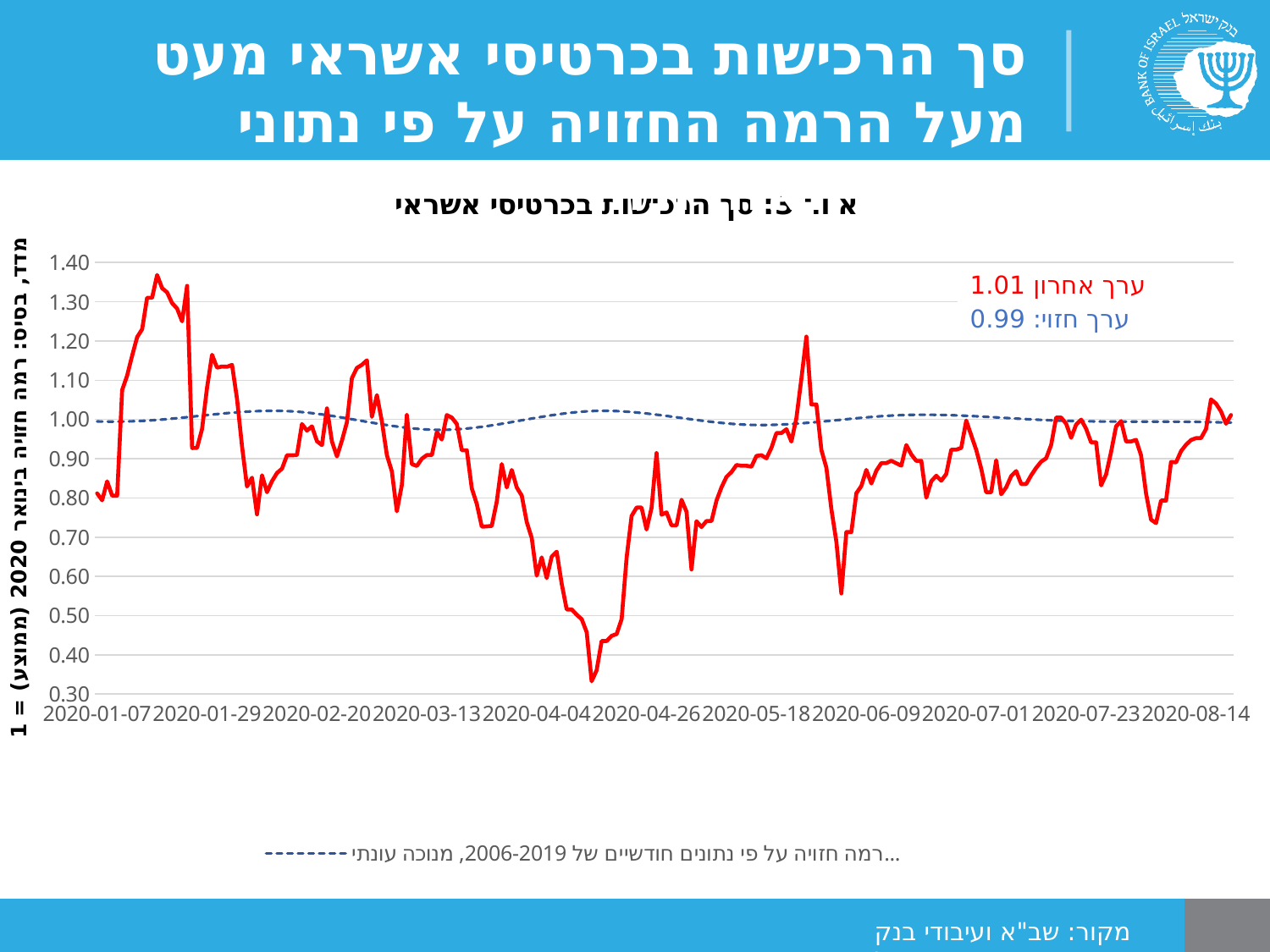
What is the last value (ערך אחרון) of the credit card purchases index shown on the chart? 1.01 Is the lowest point of the red line, near 2020-04-04, greater or less than 0.40? less Is the highest peak of the red line, in January 2020, greater or less than 1.30? greater Which is larger, the last value or the expected value shown on the chart? the last value (1.01) How many date labels are shown on the x axis? 11 What is the first date label on the x axis? 2020-01-07 Is the dip of the red line near 2020-06-09 greater or less than 0.70? less What kind of chart is shown on the slide? line chart What is the difference between the last value (1.01) and the expected value (0.99) shown on the chart? 0.02 What colour is the dashed line representing the expected level? blue Does the red line rise or fall between 2020-03-13 and 2020-04-04? fall What is the expected value (ערך חזוי) shown on the chart? 0.99